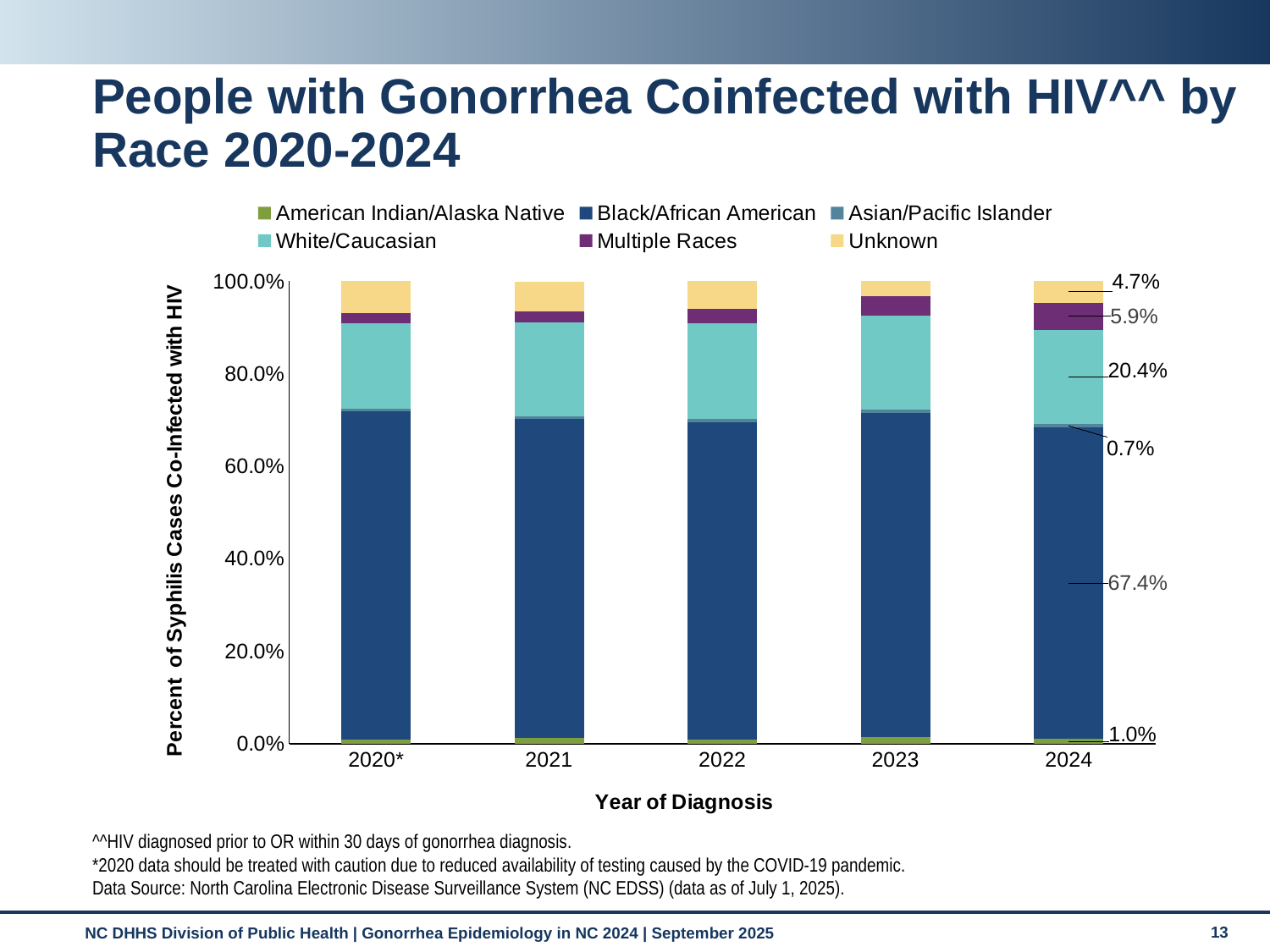
In 2024, which race group has the largest share of the bar? Black/African American How many series does the legend list? 6 What percentage of people with gonorrhea coinfected with HIV in 2024 were Black/African American? 67.4% What is the Unknown share for 2024? 4.7% What value is labeled for Multiple Races in 2024? 5.9% In 2024, how much larger is the Black/African American share than the White/Caucasian share? 47.0% What is the American Indian/Alaska Native share for 2024? 1.0% In 2024, which is larger: the Multiple Races share or the Unknown share? Multiple Races Is the Black/African American share in 2020* greater or less than 60.0%? greater In 2024, which race group has the smallest labeled share? Asian/Pacific Islander What is the Asian/Pacific Islander share for 2024? 0.7% What is the White/Caucasian share shown for 2024? 20.4%